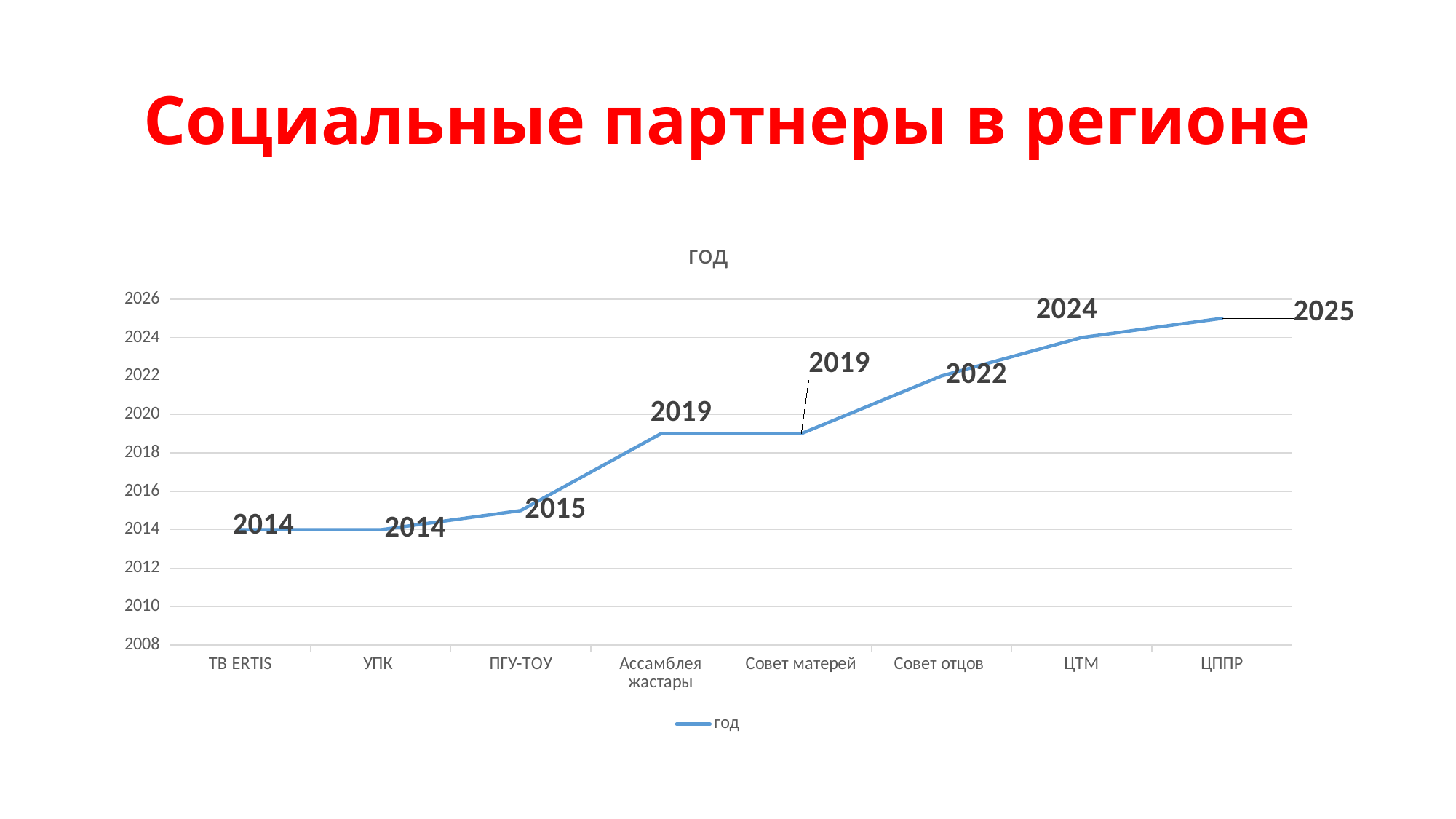
What is the difference between the values for ЦППР and ТВ ERTIS? 11 How many categories are plotted on the x axis? 8 Which is larger, the value for ЦТМ or the value for Совет отцов? ЦТМ What is the value for Ассамблея жастары? 2019 What is the value for ПГУ-ТОУ? 2015 Which category has the highest value? ЦППР How many series does the legend list? 1 Do the values rise or fall from ТВ ERTIS to ЦППР along the x axis? rise What is the value for ЦТМ? 2024 What is the value for Совет отцов? 2022 What kind of chart is shown? line chart What is the difference between the values for Совет отцов and Совет матерей? 3